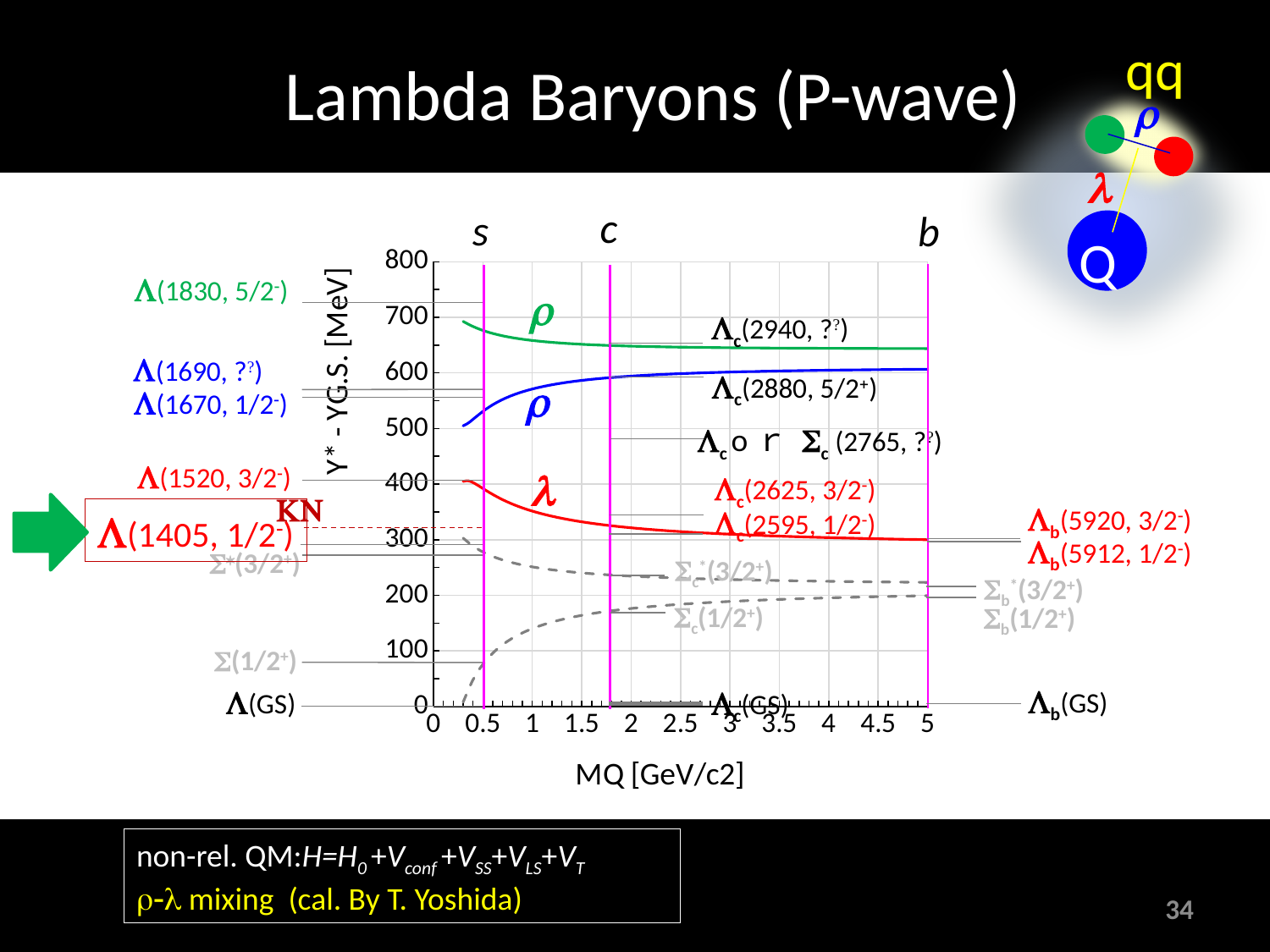
Is the value of the blue ρ curve at the line labelled s greater or less than 600? less What is the label of the x axis of the chart? MQ [GeV/c2] At the line labelled s, which is higher: the red λ curve or the blue ρ curve? the blue ρ curve At the vertical line labelled c, which is higher: the green ρ curve or the blue ρ curve? the green ρ curve Is the value of the red λ curve at the line labelled b greater or less than 400? less What three letters label the vertical magenta lines at the top of the chart, from left to right? s, c, b Is the value of the green ρ curve at the line labelled b greater or less than 600? greater Which solid curve lies highest on the chart across the whole MQ range? the green ρ curve How many vertical magenta lines are drawn on the chart? 3 Does the red λ curve rise or fall as MQ increases? fall What kind of chart is shown on the slide? line chart Does the blue ρ curve rise or fall as MQ increases? rise